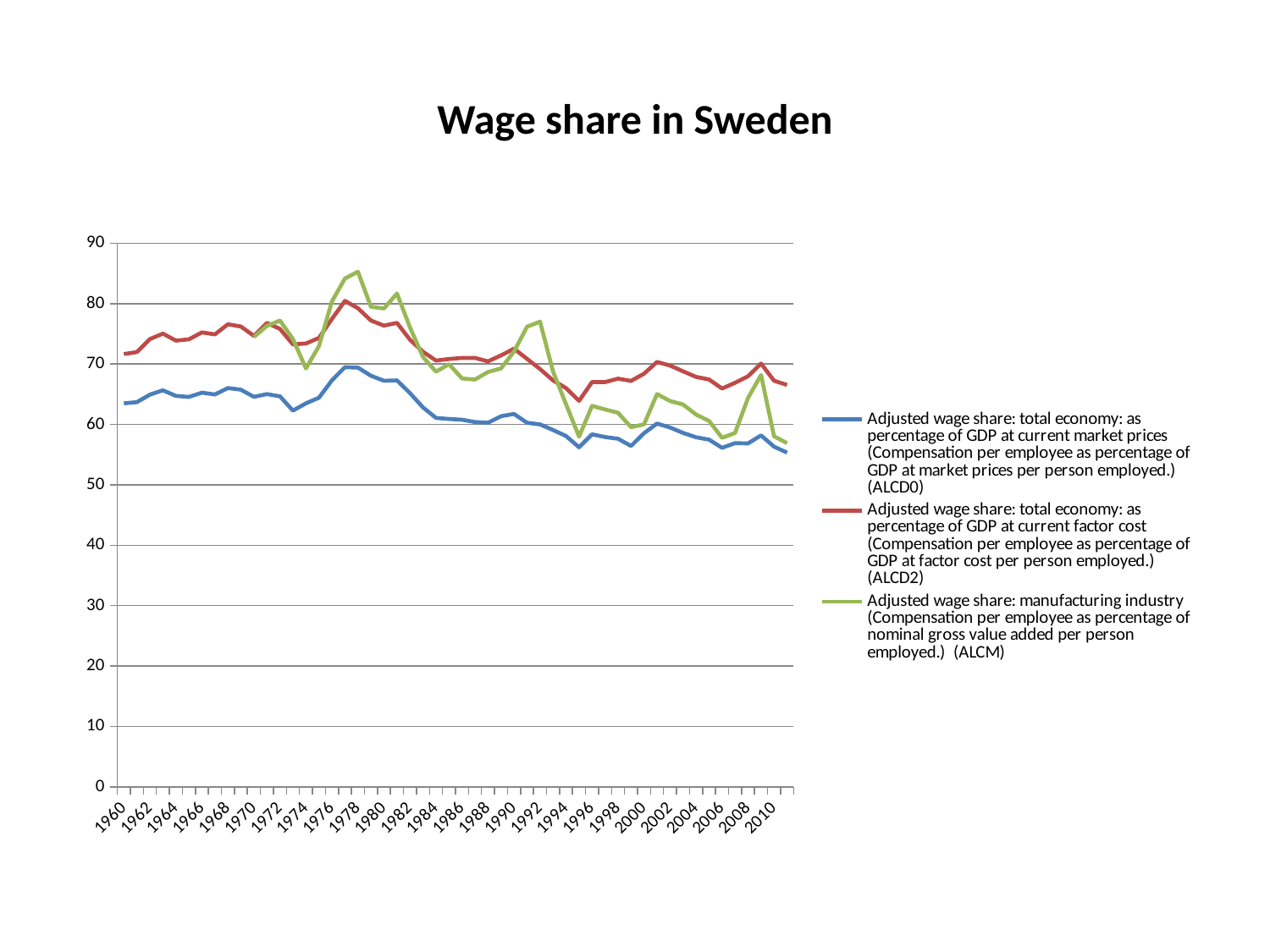
In 1996, which series has the higher value: the total economy wage share at market prices (ALCD0) or at factor cost (ALCD2)? factor cost (ALCD2) Is the value for the total economy wage share at market prices (ALCD0) in 2010 greater or less than 60? less Does the total economy wage share at market prices (ALCD0) rise or fall between 1978 and 1996? fall Which colour is used for the manufacturing industry wage share series (ALCM)? green In 1978, which series has the higher value: the total economy wage share at factor cost (ALCD2) or the manufacturing industry wage share (ALCM)? manufacturing industry (ALCM) Is the value for the total economy wage share at factor cost (ALCD2) in 1995 greater or less than 60? greater Which series reaches the highest value anywhere on the chart? manufacturing industry (ALCM) Is the value for the manufacturing industry wage share (ALCM) in 1978 greater or less than 80? greater What kind of chart is shown on the slide? line chart What is the title of the chart? Wage share in Sweden How many series does the legend list? 3